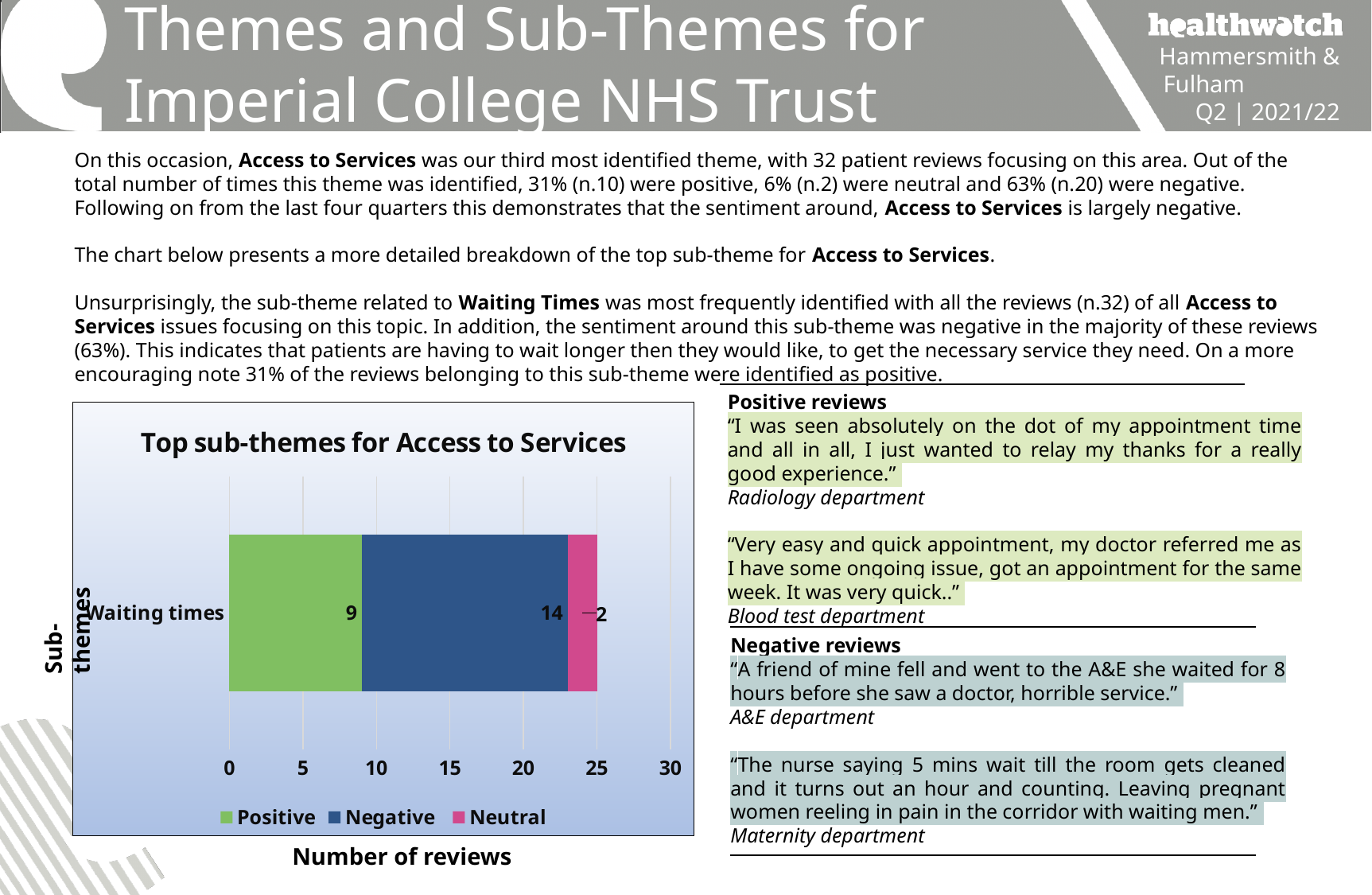
What is the Positive value for Waiting times? 9 How many series does the chart legend list? 3 Which series has the highest value for Waiting times? Negative What is the title of the chart? Top sub-themes for Access to Services Which series is shown in green in the chart? Positive What is the Neutral value for Waiting times? 2 What is the difference between the Negative and Positive values for Waiting times? 5 Which series has the lowest value for Waiting times? Neutral What is the Negative value for Waiting times? 14 How many sub-theme categories are plotted in the chart? 1 What is the total number of reviews in the Waiting times stacked bar? 25 What kind of chart is shown on the slide? bar chart